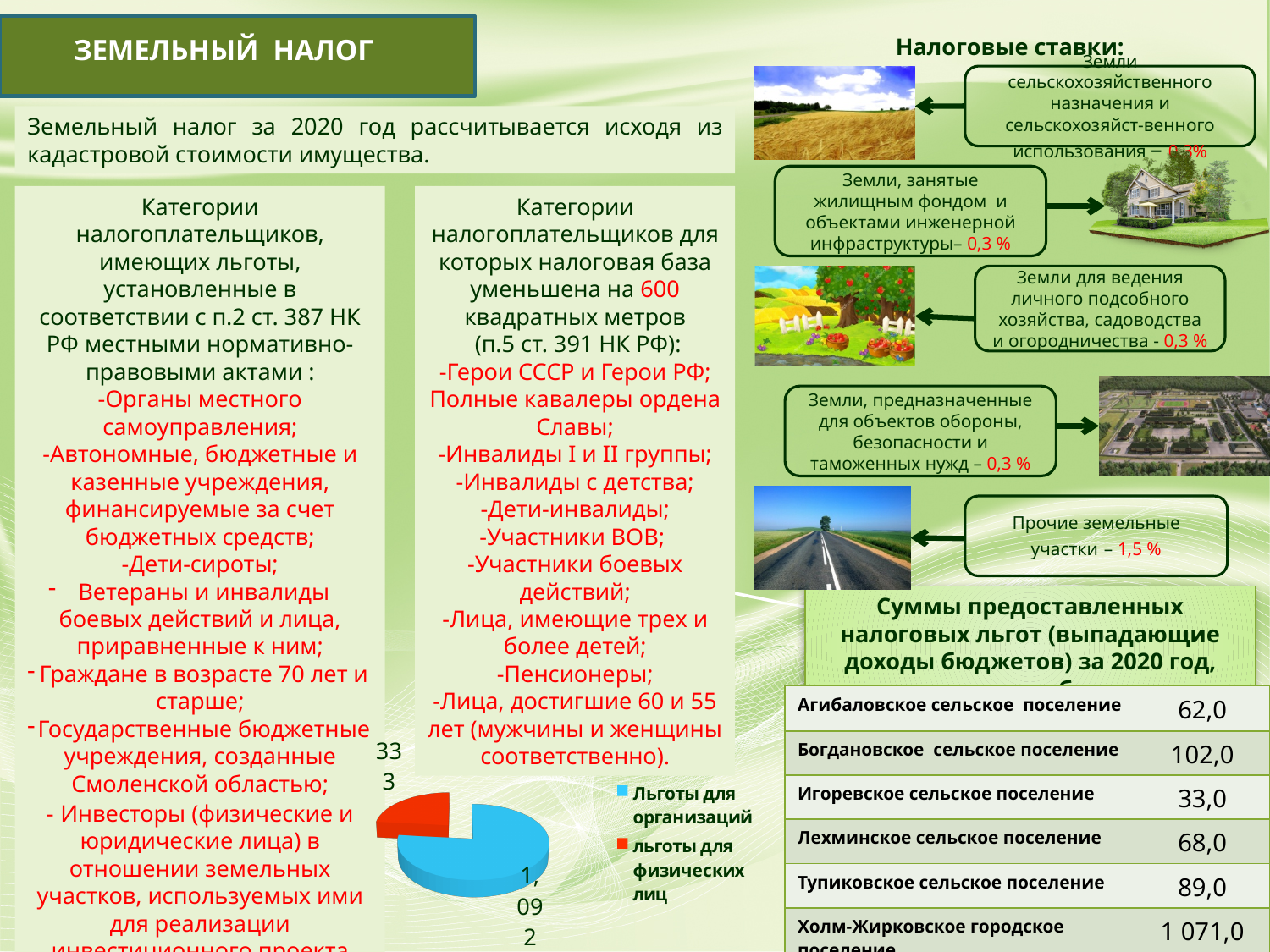
What colour is the 'льготы для физических лиц' slice in the pie chart? red In the pie chart, which slice is larger: 'Льготы для организаций' or 'льготы для физических лиц'? Льготы для организаций What colour is the 'Льготы для организаций' slice in the pie chart? blue What value is labelled on the 'Льготы для организаций' slice of the pie chart? 1,092 What kind of chart is shown at the bottom of the slide? pie chart Which category has the largest share of the pie chart? Льготы для организаций Which category has the smallest share of the pie chart? льготы для физических лиц How many slices does the pie chart have? 2 How many entries does the legend of the pie chart list? 2